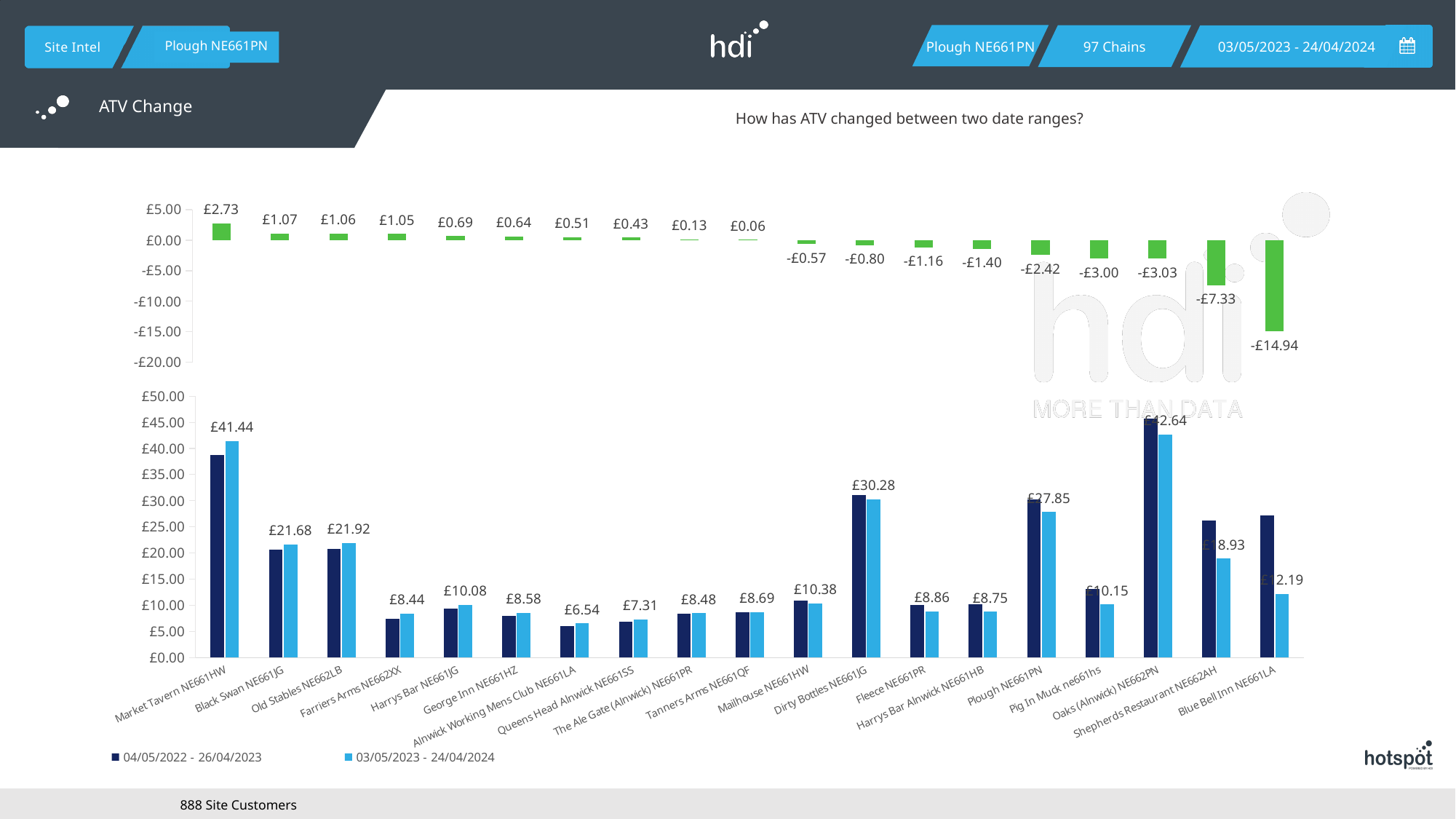
In the bottom chart, which has the larger 03/05/2023 - 24/04/2024 value: Dirty Bottles NE661JG or Plough NE661PN? Dirty Bottles NE661JG In the bottom chart, what is the difference between the 03/05/2023 - 24/04/2024 values for Old Stables NE662LB and Black Swan NE661JG? £0.24 In the bottom chart, is the 04/05/2022 - 26/04/2023 value for Plough NE661PN greater or less than £25.00? greater In the bottom chart, what is the value for Market Tavern NE661HW in the 03/05/2023 - 24/04/2024 series? £41.44 How many series does the legend of the bottom chart list? 2 What kind of chart is the bottom chart on the slide? bar chart In the bottom chart, what is the value for Oaks (Alnwick) NE662PN in the 03/05/2023 - 24/04/2024 series? £42.64 In the top chart (ATV change), what is the largest value shown? £2.73 How many bars are plotted in the top chart (ATV change)? 19 In the top chart (ATV change), what is the lowest value shown? -£14.94 In the bottom chart, which site has the lowest value in the 03/05/2023 - 24/04/2024 series? Alnwick Working Mens Club NE661LA In the bottom chart, which site has the highest value in the 03/05/2023 - 24/04/2024 series? Oaks (Alnwick) NE662PN